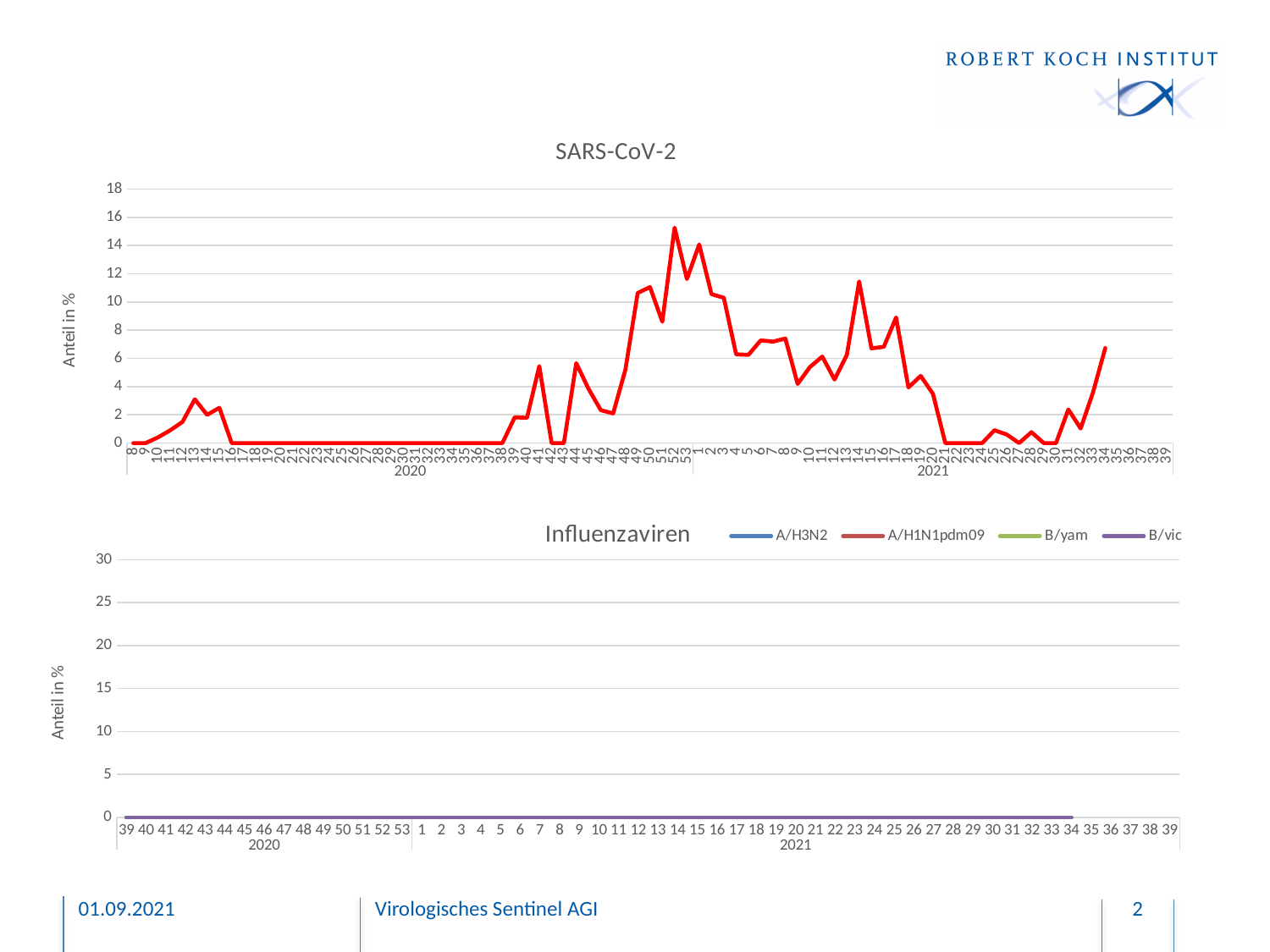
What is the y-axis label of the SARS-CoV-2 chart? Anteil in % What kind of chart is the Influenzaviren chart at the bottom of the slide? line chart In the SARS-CoV-2 chart, do the values rise or fall from week 49 of 2020 to week 52 of 2020? rise In the SARS-CoV-2 chart, is the value for week 22 of 2021 greater or less than 2? less In the SARS-CoV-2 chart, is the value for week 13 of 2020 greater or less than 2? greater How many series does the legend of the Influenzaviren chart list? 4 In the Influenzaviren chart, which series are listed in the legend? A/H3N2, A/H1N1pdm09, B/yam, B/vic What kind of chart is the SARS-CoV-2 chart at the top of the slide? line chart In the Influenzaviren chart, is the value for A/H3N2 in week 10 of 2021 greater or less than 5? less